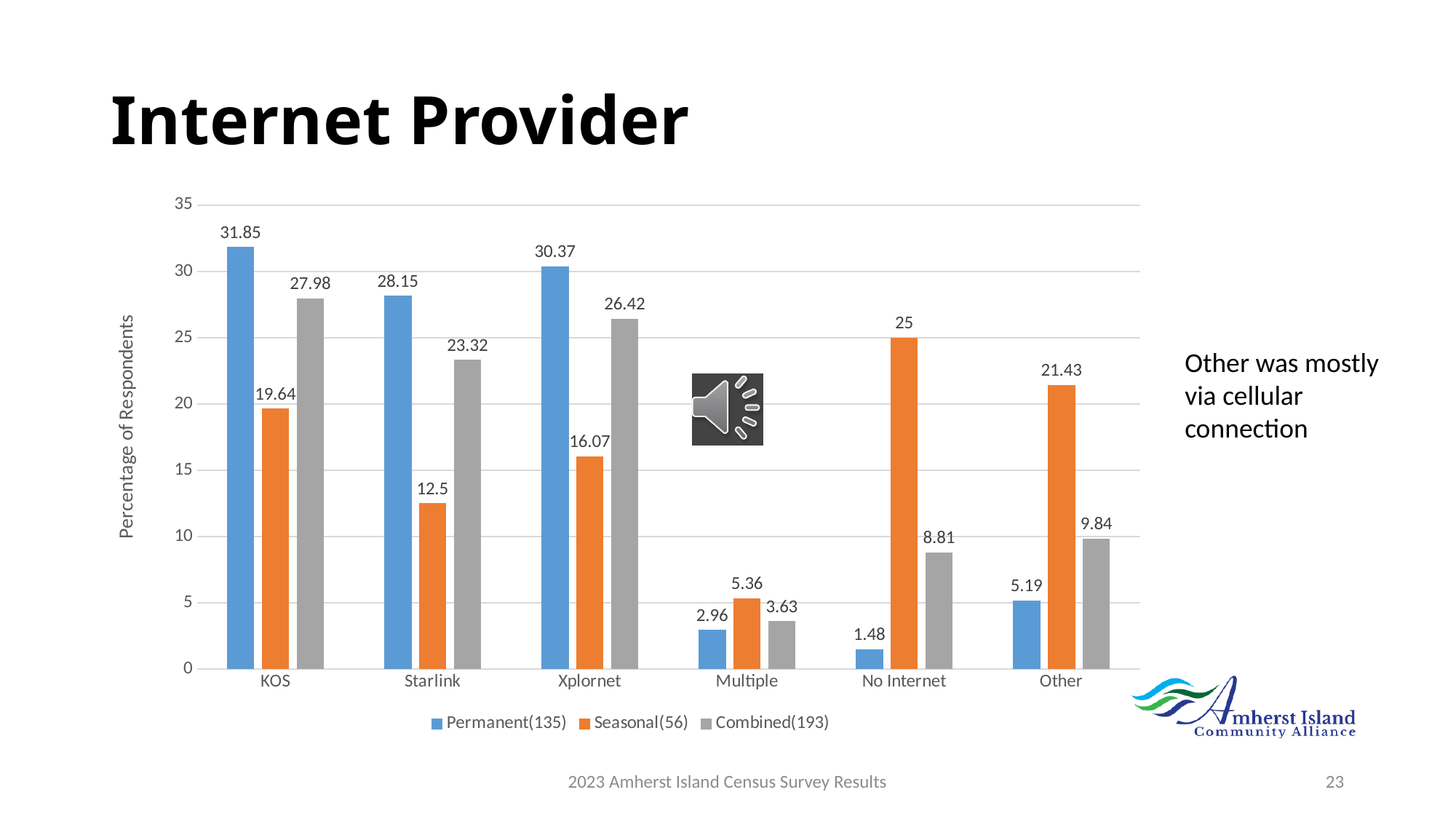
How many categories are shown on the x axis? 6 What is the Permanent(135) value for KOS? 31.85 What is the Combined(193) value for Xplornet? 26.42 How many series does the legend list? 3 Which category has the lowest Permanent(135) value? No Internet Which category has the highest Seasonal(56) value? No Internet What kind of chart is shown on the slide? bar chart Is the Combined(193) value for Starlink greater or less than 20? greater What is the difference between the Permanent(135) and Seasonal(56) values for Starlink? 15.65 Which is larger for Other: the Seasonal(56) value or the Combined(193) value? Seasonal(56) What is the Seasonal(56) value for No Internet? 25 What is the y-axis label of the chart? Percentage of Respondents